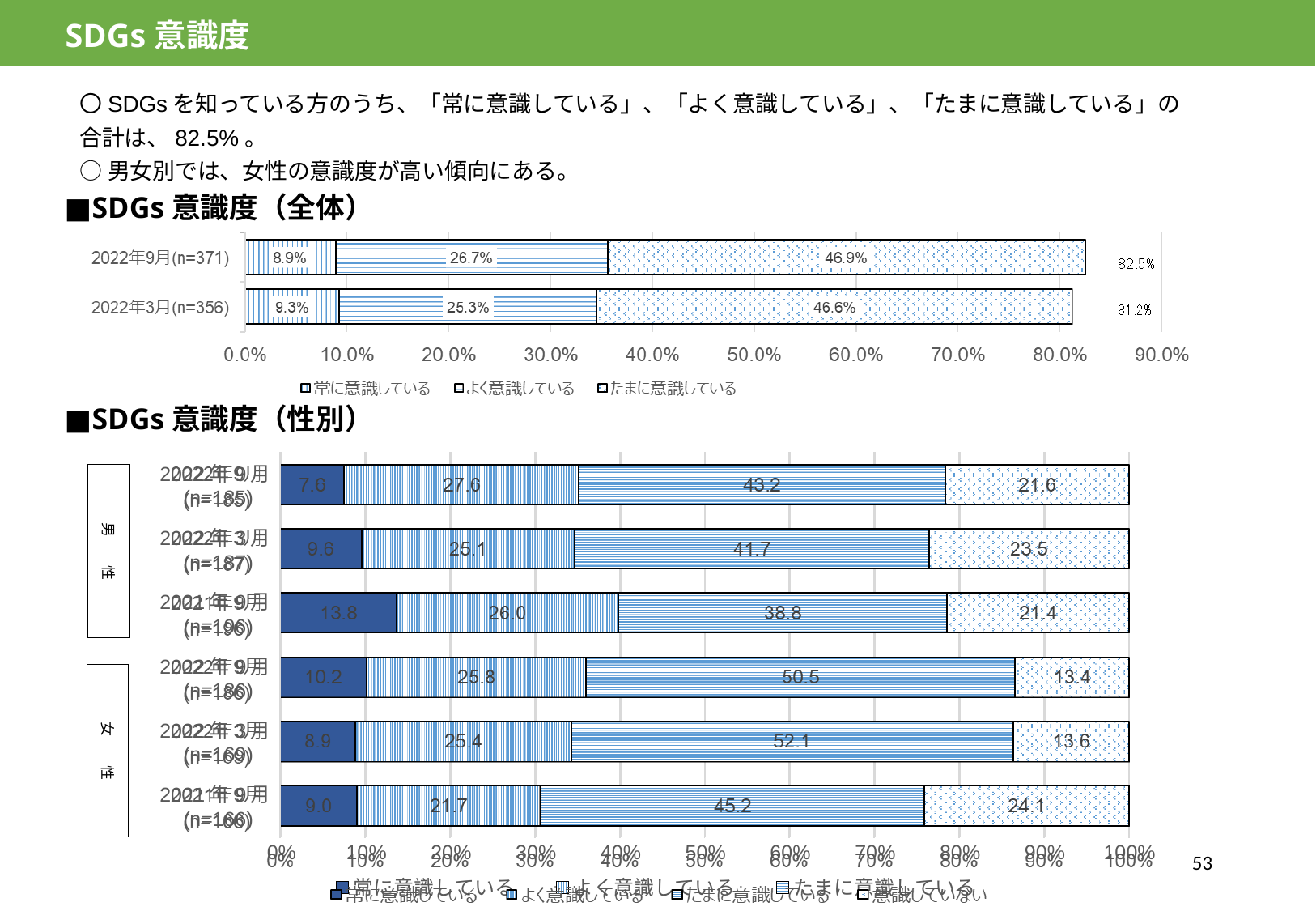
In the SDGs 意識度（全体） chart, which period has the larger 常に意識している value, 2022年9月 or 2022年3月? 2022年3月 In the SDGs 意識度（性別） chart, what is the value of the third segment (たまに意識している) in the topmost 男性 bar? 43.2 In the SDGs 意識度（全体） chart, what is the value for 常に意識している in 2022年9月(n=371)? 8.9% In the SDGs 意識度（全体） chart, what is the value for たまに意識している in 2022年9月(n=371)? 46.9% In the SDGs 意識度（全体） chart, how many series does the legend list? 3 In the SDGs 意識度（性別） chart, how many bars are shown in total? 6 In the SDGs 意識度（全体） chart, how many categories (bars) are shown? 2 What kind of chart is the SDGs 意識度（全体） chart? Stacked bar chart In the SDGs 意識度（全体） chart, what is the difference between the よく意識している values for 2022年9月 and 2022年3月? 1.4% In the SDGs 意識度（全体） chart, what is the total of the stacked bar for 2022年9月(n=371)? 82.5% In the SDGs 意識度（全体） chart, what is the value for よく意識している in 2022年3月(n=356)? 25.3% In the SDGs 意識度（全体） chart, what is the total of the stacked bar for 2022年3月(n=356)? 81.2%